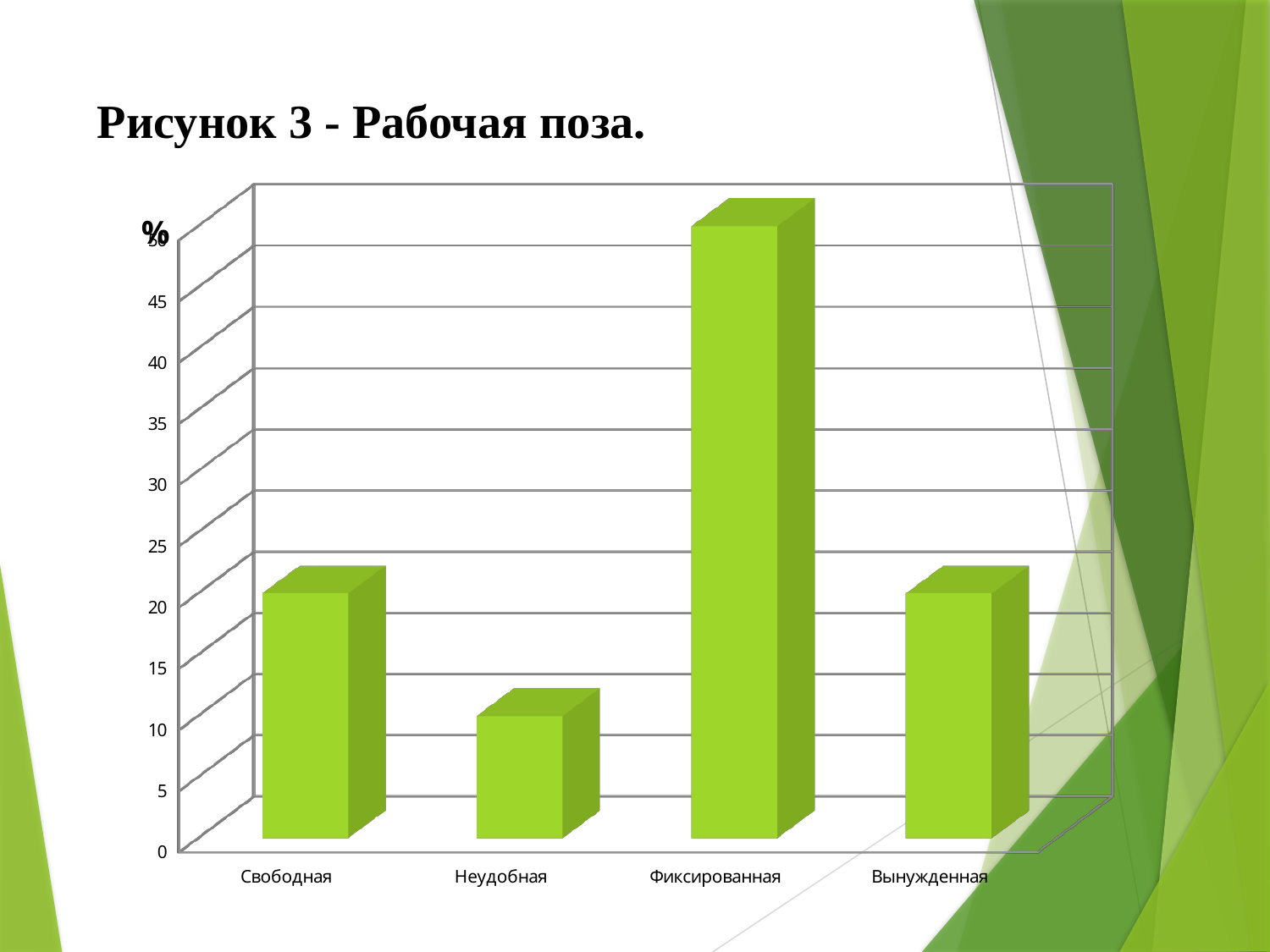
Is the value for Фиксированная greater or less than 40? greater What unit is indicated on the vertical axis of the chart? % Is the value for Вынужденная greater or less than 25? less Which category has the highest bar? Фиксированная Which category has the lowest bar? Неудобная Which is larger, the value for Фиксированная or the value for Свободная? Фиксированная What kind of chart is shown on the slide? bar chart Which is larger, the value for Неудобная or the value for Вынужденная? Вынужденная Is the value for Свободная greater or less than 15? greater How many categories are shown on the x axis of the chart? 4 What is the title of the chart on the slide? Рисунок 3 - Рабочая поза.